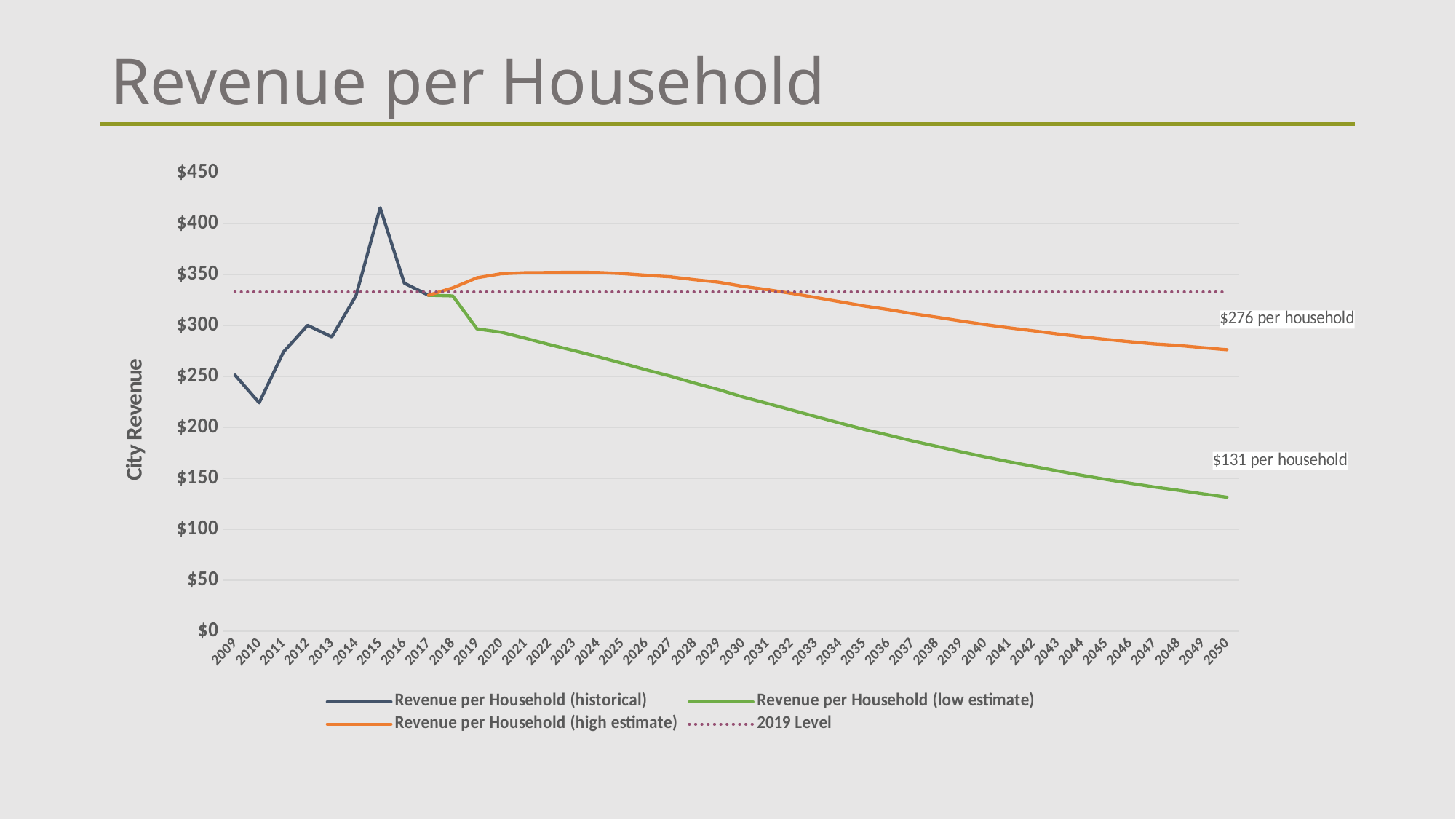
In which year does the historical Revenue per Household reach its highest value? 2015 What is the value of Revenue per Household (high estimate) in 2050? $276 per household In which year is the historical Revenue per Household lowest? 2010 What is the value of Revenue per Household (low estimate) in 2050? $131 per household Is the historical Revenue per Household value for 2010 greater or less than $250? less In 2050, which is larger: the high estimate or the low estimate of Revenue per Household? high estimate How many series does the legend list? 4 Is the historical Revenue per Household value for 2015 greater or less than $400? greater What kind of chart is shown on the slide? line chart What is the title of the vertical axis? City Revenue Does the Revenue per Household (low estimate) rise or fall from 2019 to 2050? fall What is the difference between the high estimate and the low estimate in 2050? $145